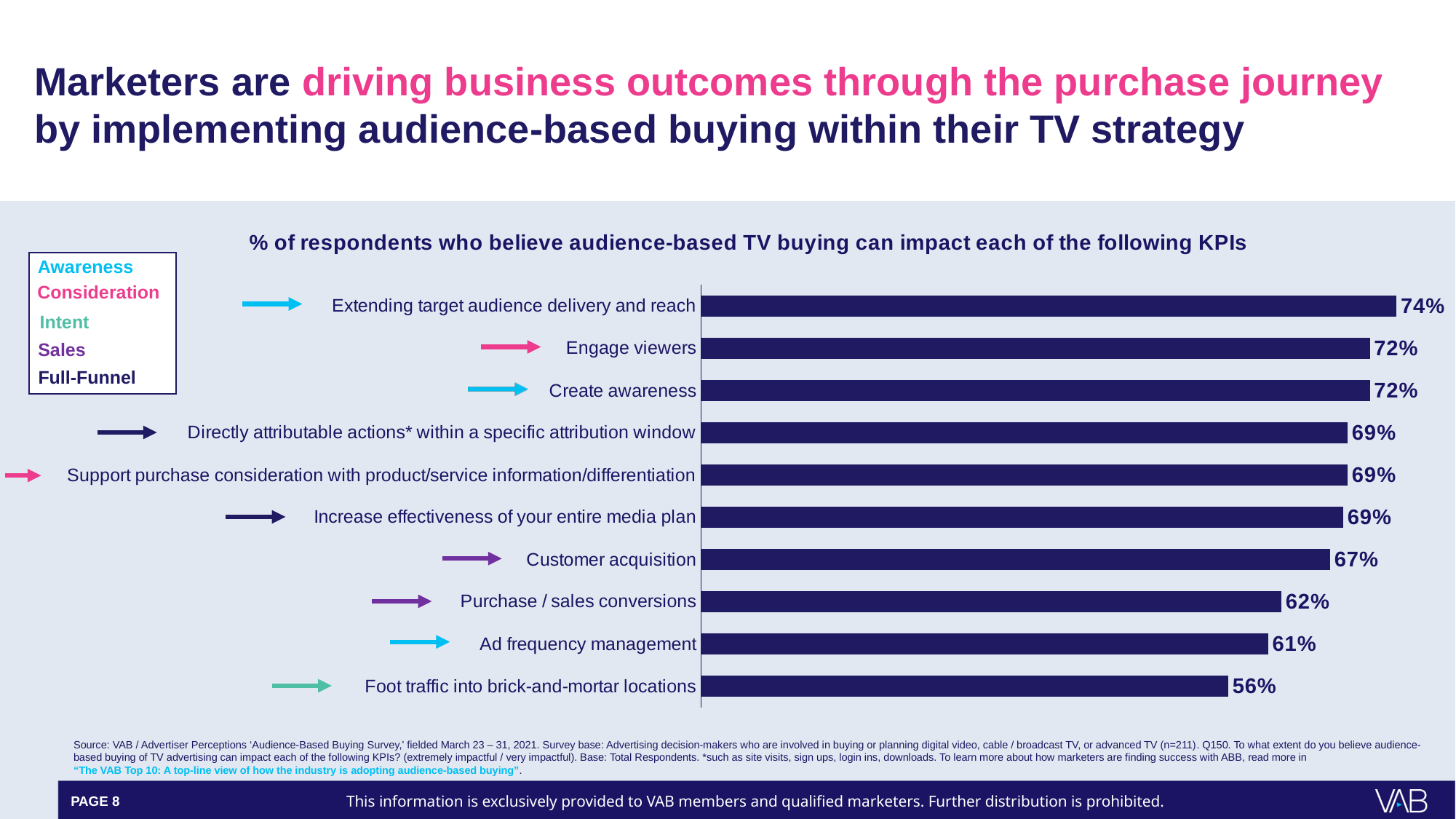
How many funnel stages are listed in the legend box on the left of the chart? 5 What is the value shown for Ad frequency management? 61% What percentage of respondents believe audience-based TV buying can impact extending target audience delivery and reach? 74% Which KPI has the lowest percentage of respondents? Foot traffic into brick-and-mortar locations What is the difference in percentage points between Extending target audience delivery and reach and Foot traffic into brick-and-mortar locations? 18 What type of chart is shown on the slide? Bar chart Which KPI has the highest percentage of respondents? Extending target audience delivery and reach What is the value shown for Foot traffic into brick-and-mortar locations? 56% Which has a higher value: Purchase / sales conversions or Customer acquisition? Customer acquisition How many KPIs are shown in the chart? 10 What is the value shown for Customer acquisition? 67% What is the title of the chart? % of respondents who believe audience-based TV buying can impact each of the following KPIs